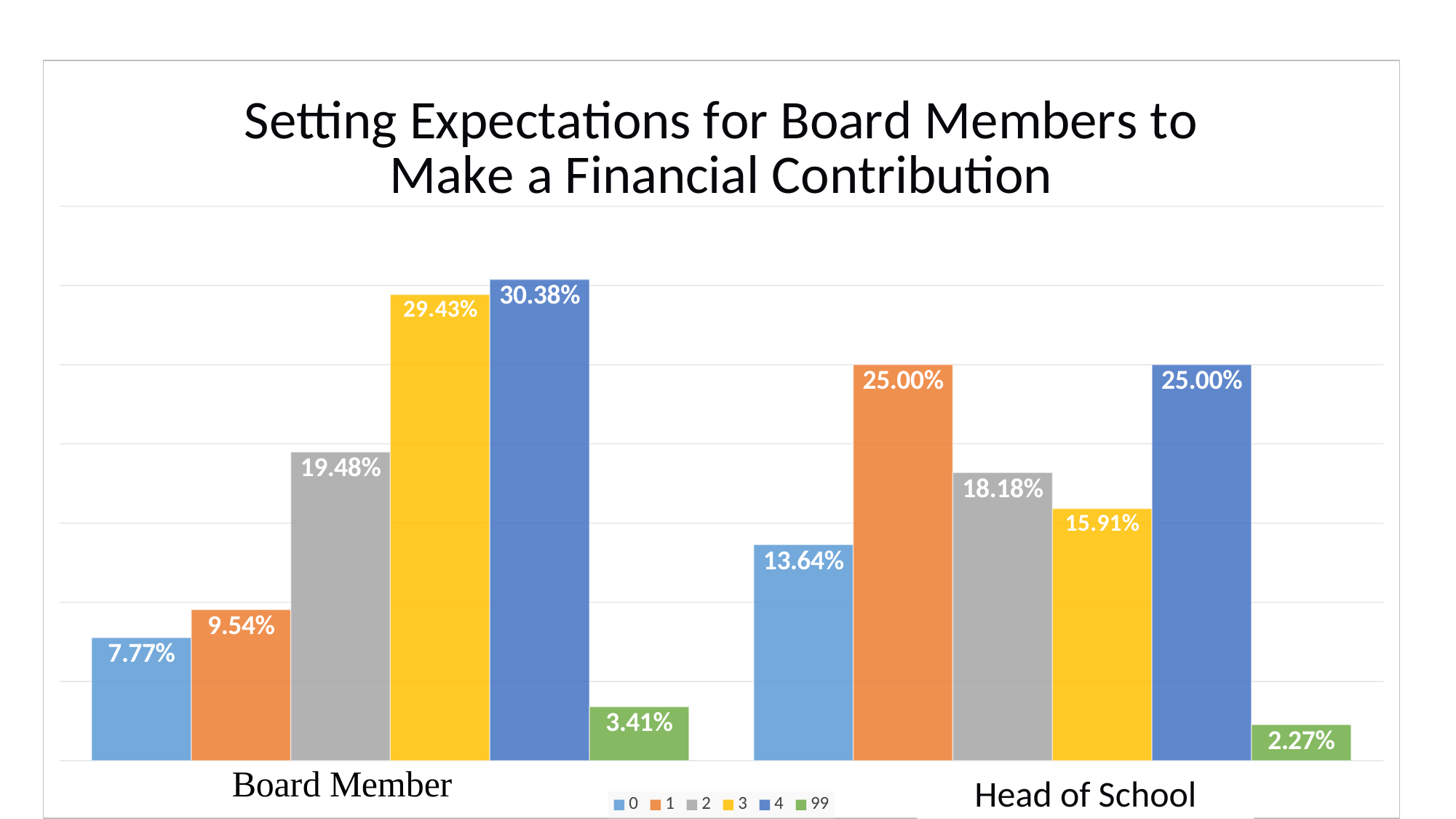
How many series does the legend list? 6 What is the value for series 0 in the Head of School category? 13.64% What is the title of the chart? Setting Expectations for Board Members to Make a Financial Contribution Which series has the highest value in the Board Member category? 4 Which series has the lowest value in the Head of School category? 99 What is the value for series 99 in the Board Member category? 3.41% What is the difference between series 3 and series 2 in the Board Member category? 9.95% How many categories are shown on the x axis? 2 What is the value for series 3 in the Head of School category? 15.91% Which is larger: series 2 for Board Member or series 2 for Head of School? Board Member What is the value for series 4 in the Board Member category? 30.38% What kind of chart is shown on the slide? Bar chart